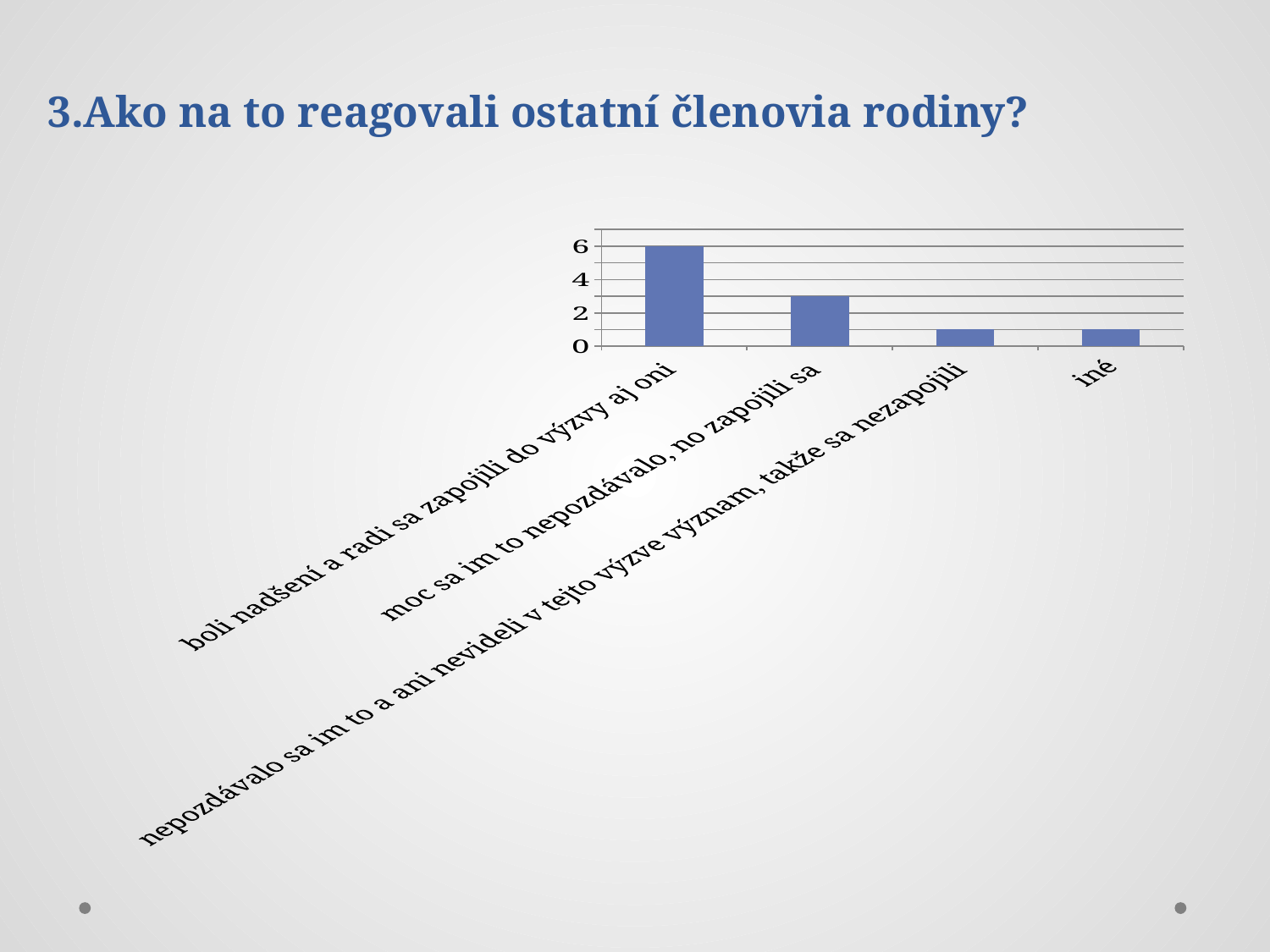
Is the value for "iné" greater or less than 2? less Is the value for "nepozdávalo sa im to a ani nevideli v tejto výzve význam, takže sa nezapojili" greater or less than 2? less Is the value for "moc sa im to nepozdávalo, no zapojili sa" greater or less than 4? less Which category has the highest value in the chart? boli nadšení a radi sa zapojili do výzvy aj oni What is the value for the category "boli nadšení a radi sa zapojili do výzvy aj oni"? 6 What is the title of the slide containing the chart? 3.Ako na to reagovali ostatní členovia rodiny? Which has a larger value: "boli nadšení a radi sa zapojili do výzvy aj oni" or "moc sa im to nepozdávalo, no zapojili sa"? boli nadšení a radi sa zapojili do výzvy aj oni What type of chart is shown on the slide? bar chart Do the values generally rise or fall from left to right along the x axis? fall How many categories are shown on the x axis of the chart? 4 Which has a larger value: "moc sa im to nepozdávalo, no zapojili sa" or "iné"? moc sa im to nepozdávalo, no zapojili sa